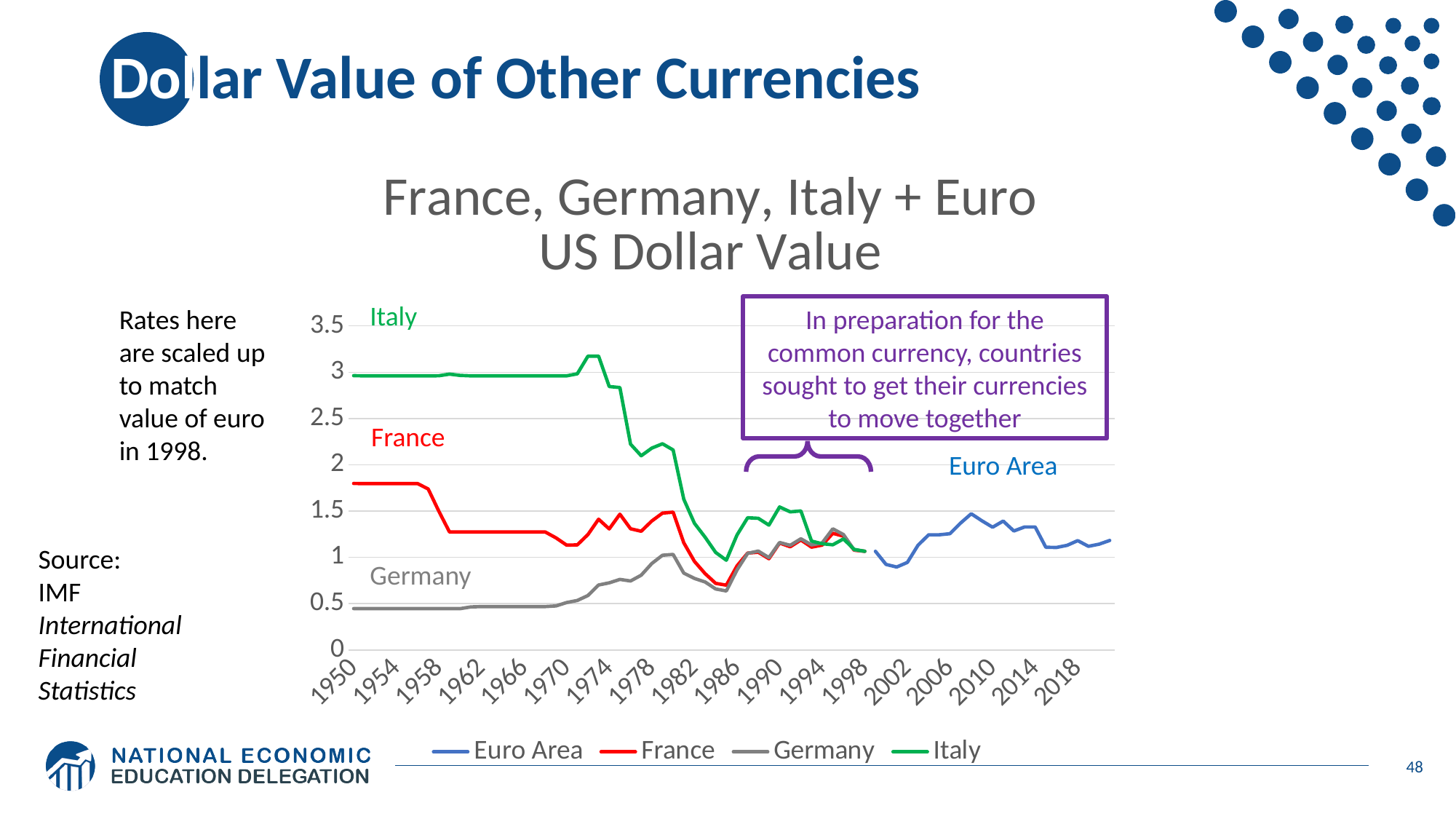
In 1962, which is larger, the value for France or the value for Germany? France Is the value for Italy in 1950 greater or less than 2.5? greater Is the value for France in 1950 greater or less than 1.5? greater How many series does the chart legend list? 4 Is the value for Euro Area in 2010 greater or less than 1? greater Does the Italy line generally rise or fall between 1974 and 1986? fall Which series has the highest value in 1950? Italy Which series are listed in the chart legend? Euro Area, France, Germany, Italy What colour is the Italy line in the chart? green Which series has the lowest value in 1950? Germany What kind of chart is shown on the slide? line chart